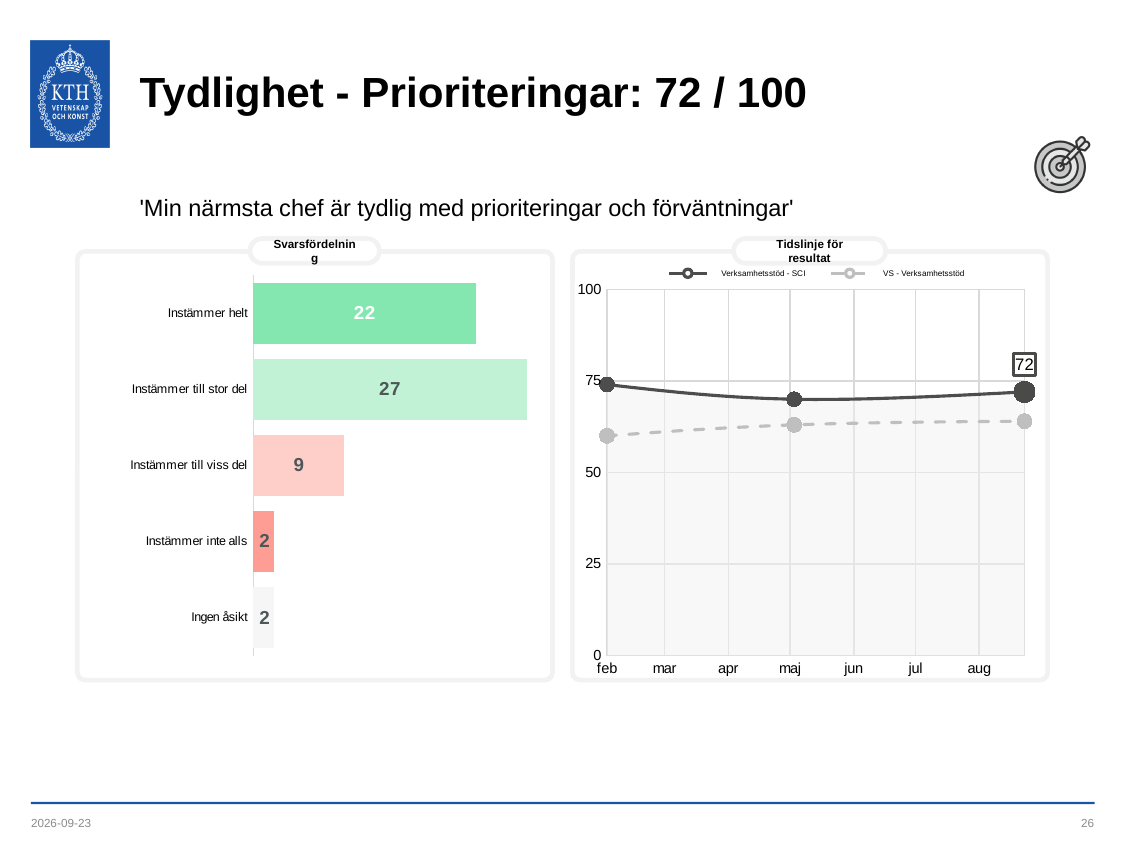
In the Svarsfördelning chart, which category has the highest value? Instämmer till stor del In the Svarsfördelning chart, what is the difference between 'Instämmer till stor del' and 'Instämmer helt'? 5 In the Svarsfördelning chart, what is the value for 'Instämmer helt'? 22 In the Tidslinje för resultat chart, which series is higher in maj: Verksamhetsstöd - SCI or VS - Verksamhetsstöd? Verksamhetsstöd - SCI In the Svarsfördelning chart, what is the value for 'Instämmer till stor del'? 27 In the Svarsfördelning chart, which is larger: 'Instämmer till viss del' or 'Instämmer inte alls'? Instämmer till viss del In the Tidslinje för resultat chart, is the value of VS - Verksamhetsstöd in feb greater or less than 75? less In the Svarsfördelning chart, what is the value for 'Instämmer till viss del'? 9 What kind of chart is the Svarsfördelning chart? bar chart How many categories does the Svarsfördelning chart show? 5 How many series does the legend of the Tidslinje för resultat chart list? 2 In the Tidslinje för resultat chart, what is the value of Verksamhetsstöd - SCI in aug? 72